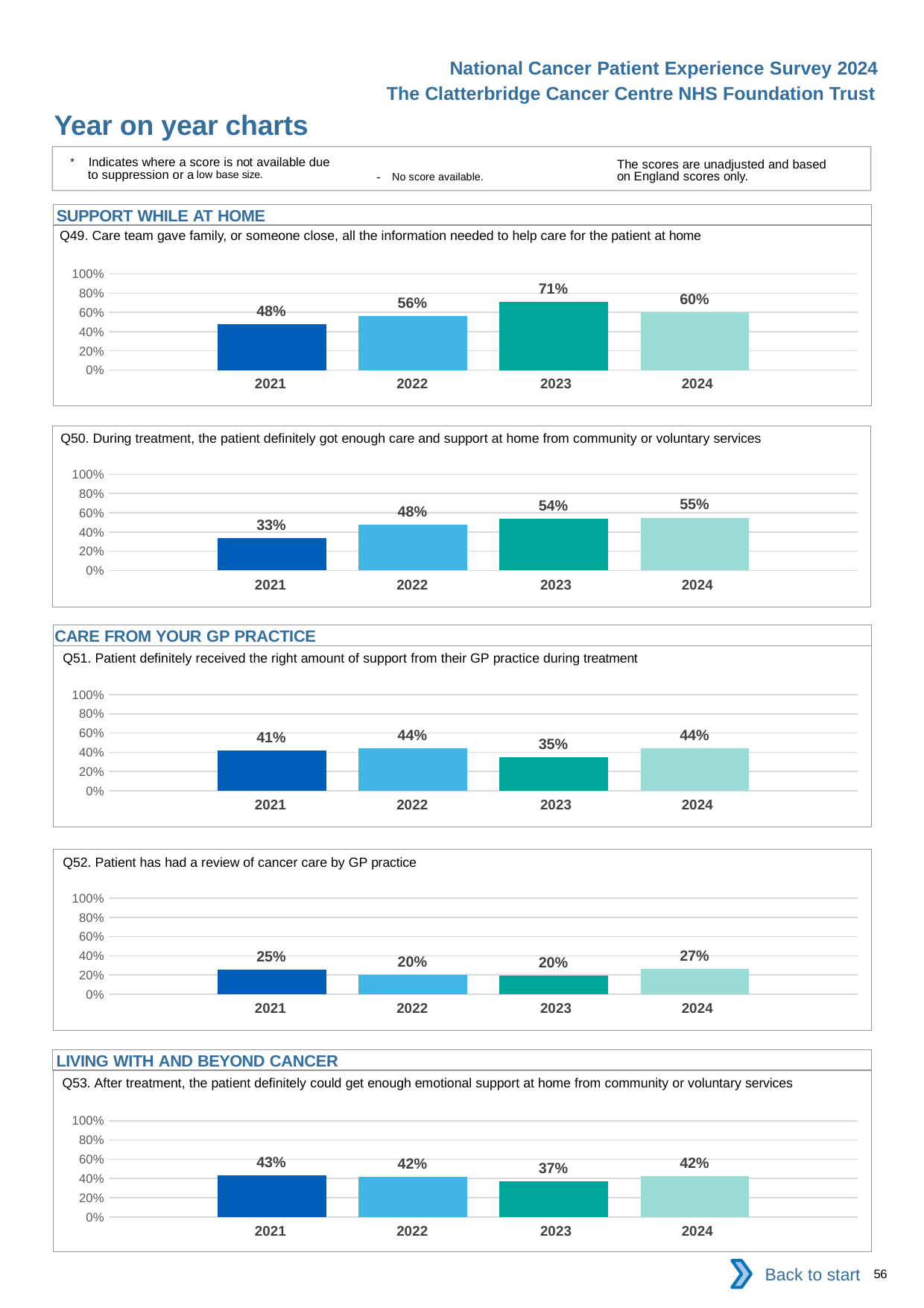
In the Q53 chart, what is the value for 2024? 42% In the Q49 chart, what is the value for 2023? 71% In the Q52 chart, what is the difference between the 2021 and 2022 values? 5 percentage points In the Q50 chart, what is the difference between the 2024 and 2021 values? 22 percentage points In the Q50 chart, which year has the lowest value? 2021 In the Q51 chart, what is the value for 2021? 41% In the Q50 chart, do the values rise or fall from 2021 to 2024? rise In the Q51 chart, which year has the lowest value? 2023 How many years are shown in the Q49 chart? 4 In the Q52 chart, which year has the highest value? 2024 What kind of chart is used for Q50? bar chart In the Q53 chart, is the value for 2021 larger or smaller than the value for 2023? larger